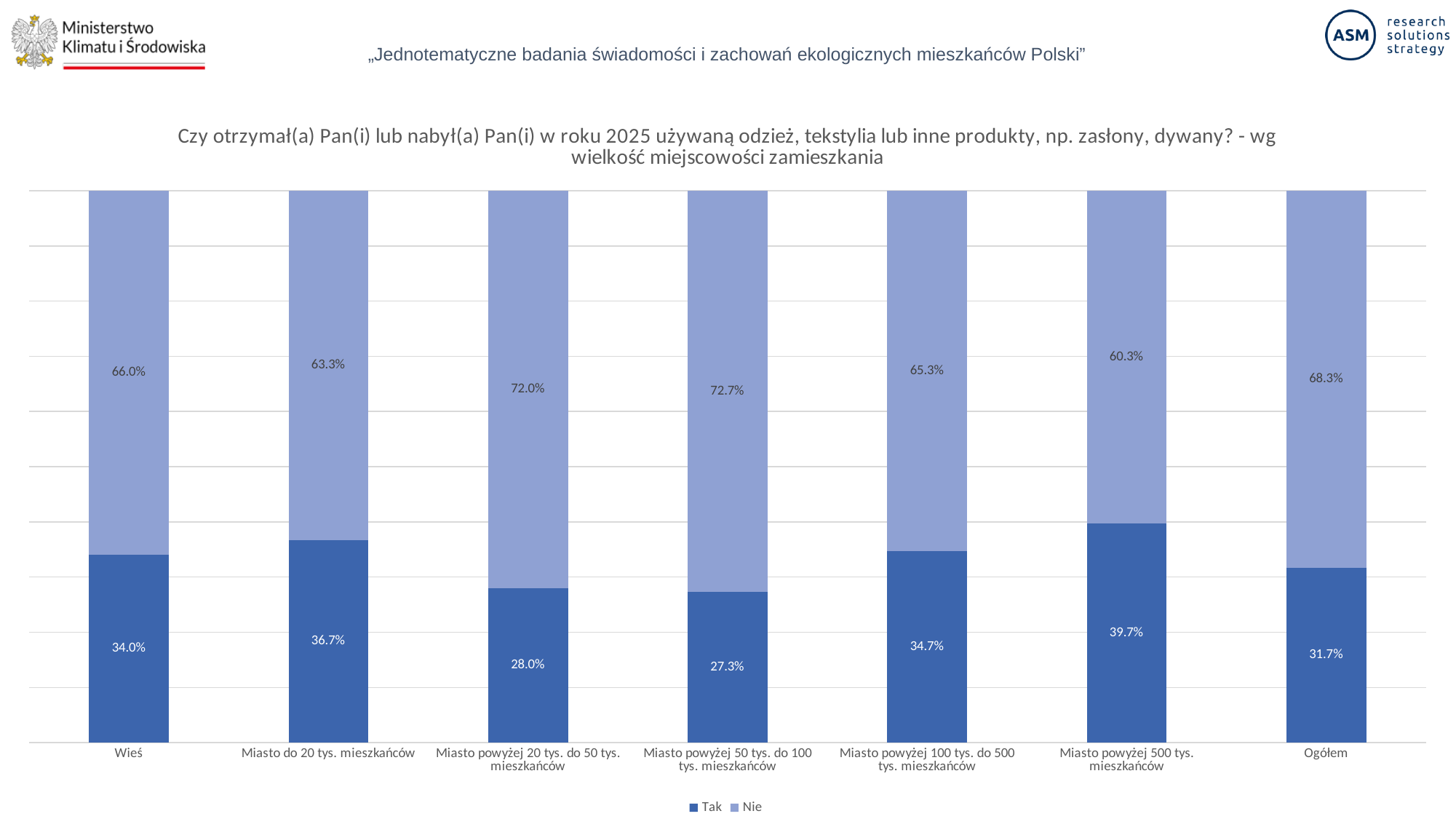
What is the difference between the "Nie" values for Miasto powyżej 20 tys. do 50 tys. mieszkańców and Miasto do 20 tys. mieszkańców? 8.7 percentage points What is the "Tak" value for Ogółem? 31.7% Which category has the highest "Tak" value? Miasto powyżej 500 tys. mieszkańców What is the "Tak" value for Wieś? 34.0% What kind of chart is shown on the slide? Stacked bar chart What is the total of the stacked bar for Miasto powyżej 50 tys. do 100 tys. mieszkańców? 100.0% How many categories are shown on the x axis? 7 How many series does the legend list? 2 Which category has the lowest "Tak" value? Miasto powyżej 50 tys. do 100 tys. mieszkańców What is the "Nie" value for Miasto powyżej 500 tys. mieszkańców? 60.3% What are the two series listed in the legend? Tak and Nie Which is larger: the "Tak" value for Wieś or the "Tak" value for Miasto powyżej 100 tys. do 500 tys. mieszkańców? Miasto powyżej 100 tys. do 500 tys. mieszkańców